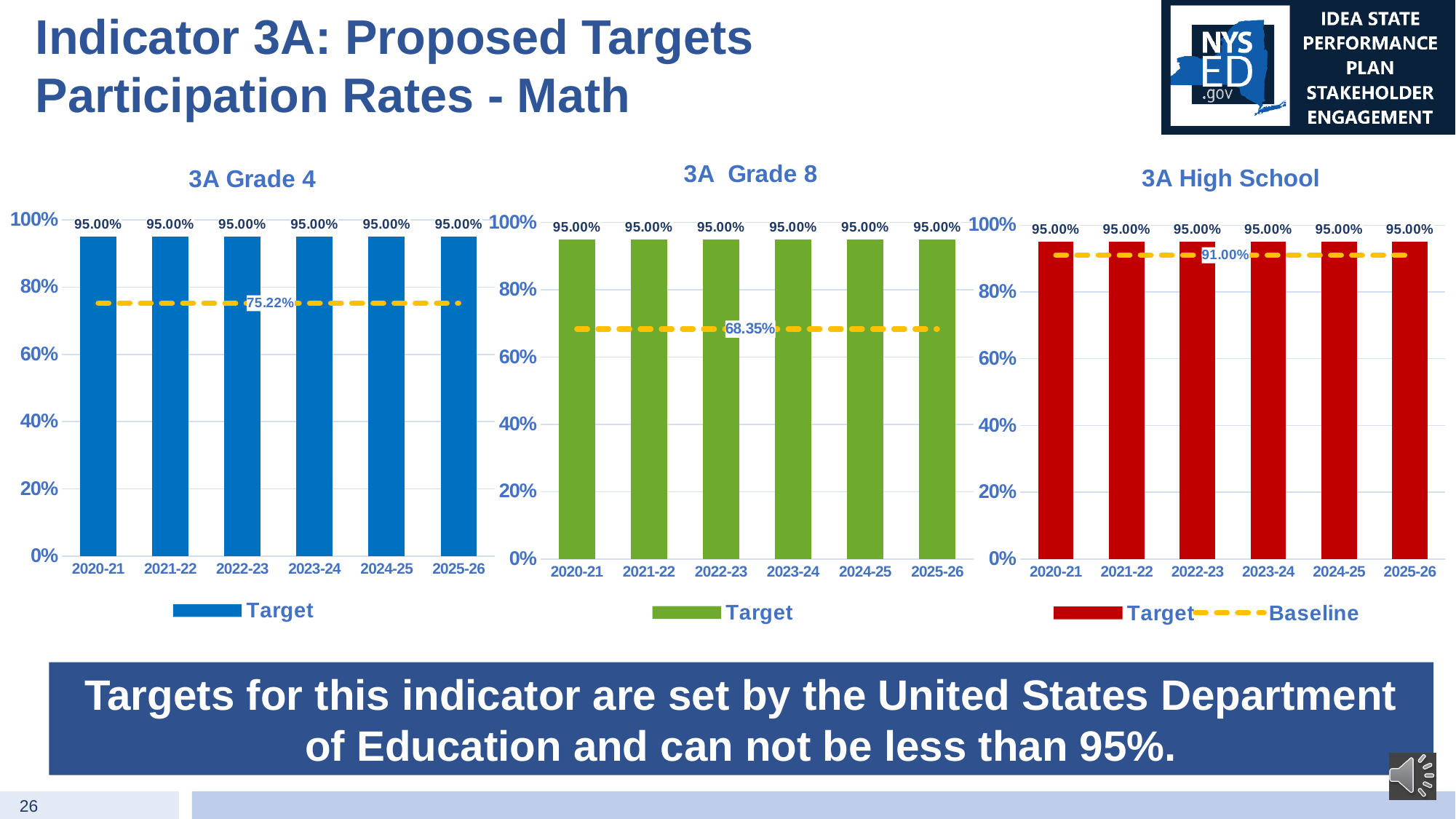
In the 3A Grade 8 chart, is the Baseline value greater or less than 80%? less How many school years are shown on the x axis of the 3A Grade 8 chart? 6 In the 3A Grade 4 chart, what is the Baseline value shown on the dashed line? 75.22% Which chart has the higher Baseline value, 3A Grade 4 or 3A Grade 8? 3A Grade 4 In the 3A Grade 8 chart, what is the Baseline value shown on the dashed line? 68.35% What kind of chart is the 3A Grade 4 chart? bar chart In the 3A High School chart, what is the Baseline value shown on the dashed line? 91.00% In the 3A Grade 4 chart, do the Target values rise, fall, or stay the same from 2020-21 to 2025-26? stay the same In the 3A Grade 4 chart, what is the Target value for 2022-23? 95.00% In the 3A High School chart, what is the Target value for 2025-26? 95.00% In the 3A High School chart, what is the difference between the Target for 2020-21 and the Baseline? 4.00% How many entries does the legend of the 3A High School chart list? 2